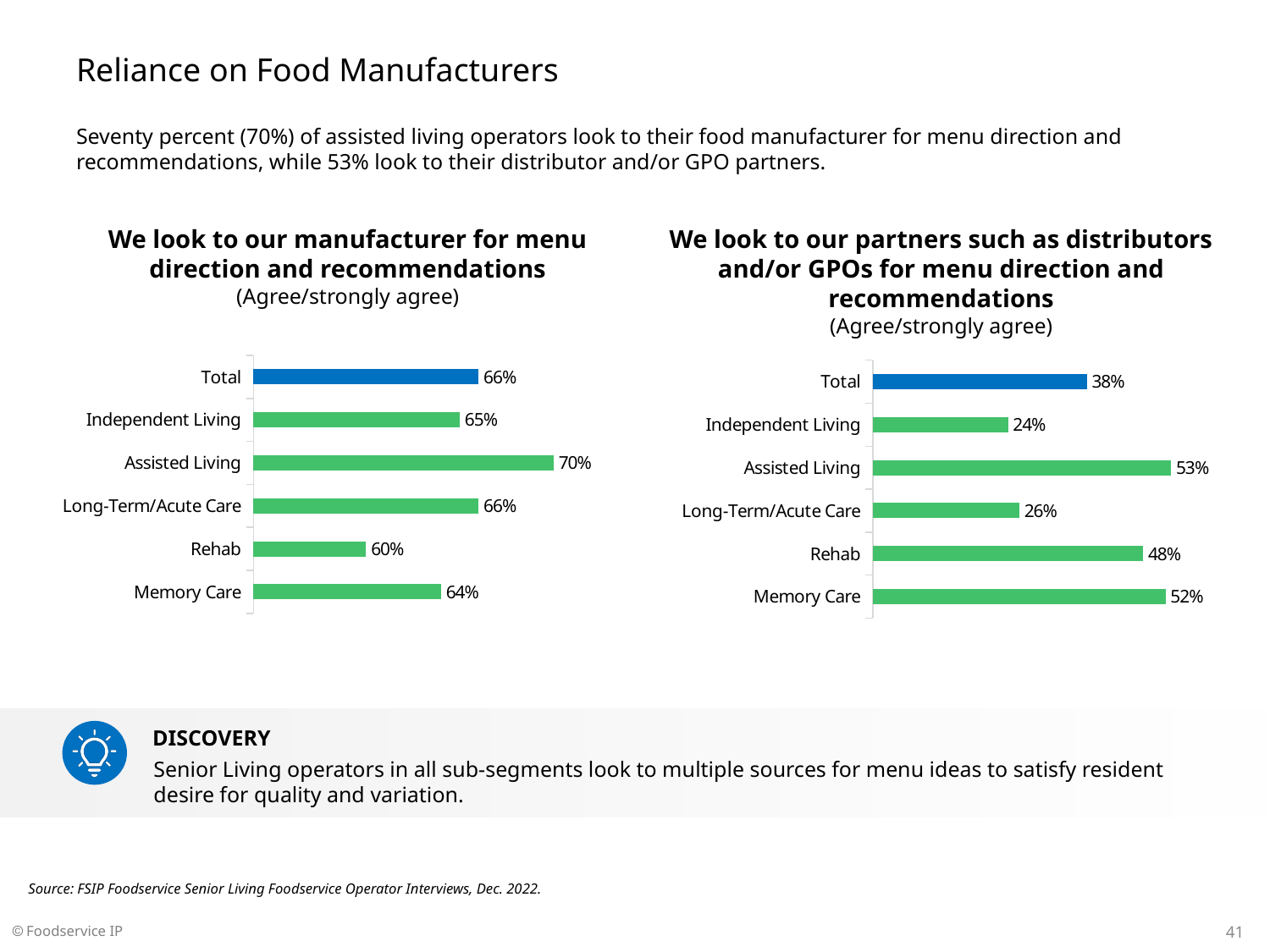
In the left chart (manufacturer), which category has the lowest value? Rehab In the chart titled "We look to our partners such as distributors and/or GPOs for menu direction and recommendations", what is the value for Independent Living? 24% In the right chart (distributors and/or GPOs), what is the difference between the values for Assisted Living and Independent Living? 29% In the chart titled "We look to our manufacturer for menu direction and recommendations", what is the value for Assisted Living? 70% In the right chart (distributors and/or GPOs), which category has the lowest value? Independent Living What type of chart is the right chart (distributors and/or GPOs)? Bar chart In the left chart (manufacturer), what is the value for Total? 66% How many categories are shown in the left chart (manufacturer)? 6 In the left chart (manufacturer), what is the difference between the values for Assisted Living and Rehab? 10% In the left chart (manufacturer), which category has the highest value? Assisted Living In the right chart (distributors and/or GPOs), which is larger, the value for Rehab or the value for Long-Term/Acute Care? Rehab In the right chart (distributors and/or GPOs), which category has the highest value? Assisted Living